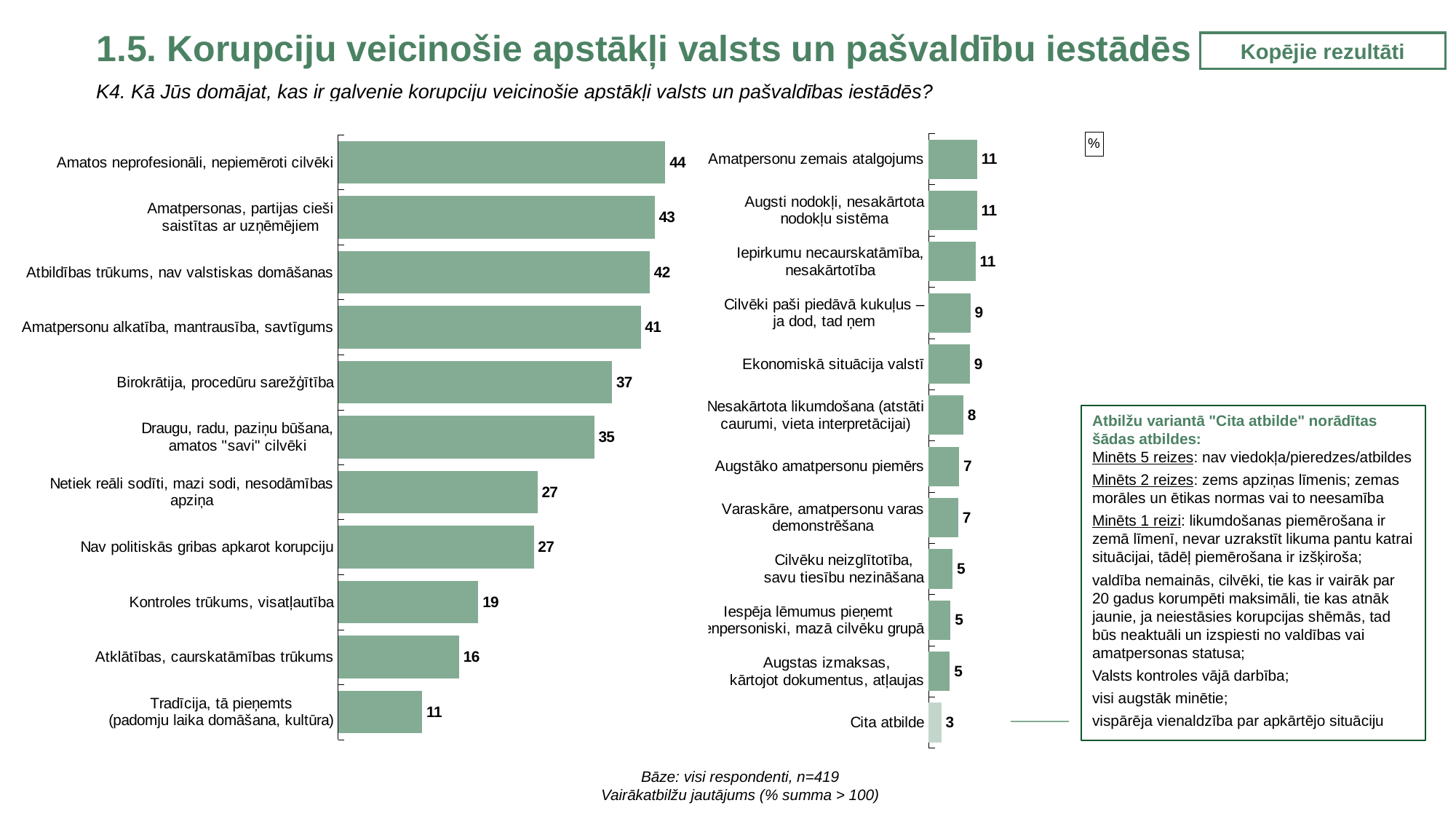
On the right chart, what is the value for "Cita atbilde"? 3 On the left chart, what is the difference between the values for "Kontroles trūkums, visatļautība" and "Atklātības, caurskatāmības trūkums"? 3 On the right chart, what is the value for "Ekonomiskā situācija valstī"? 9 On the left chart, which category has the highest value? Amatos neprofesionāli, nepiemēroti cilvēki On the left chart, what is the value for "Birokrātija, procedūru sarežģītība"? 37 On the left chart, what is the value for "Amatos neprofesionāli, nepiemēroti cilvēki"? 44 On the left chart, which category has the lowest value? Tradīcija, tā pieņemts (padomju laika domāšana, kultūra) How many categories are shown on the right chart? 12 On the left chart, which is larger: the value for "Draugu, radu, paziņu būšana, amatos "savi" cilvēki" or for "Nav politiskās gribas apkarot korupciju"? Draugu, radu, paziņu būšana, amatos "savi" cilvēki How many categories are shown on the left chart? 11 On the right chart, which category has the lowest value? Cita atbilde What type of chart is the left chart? Bar chart